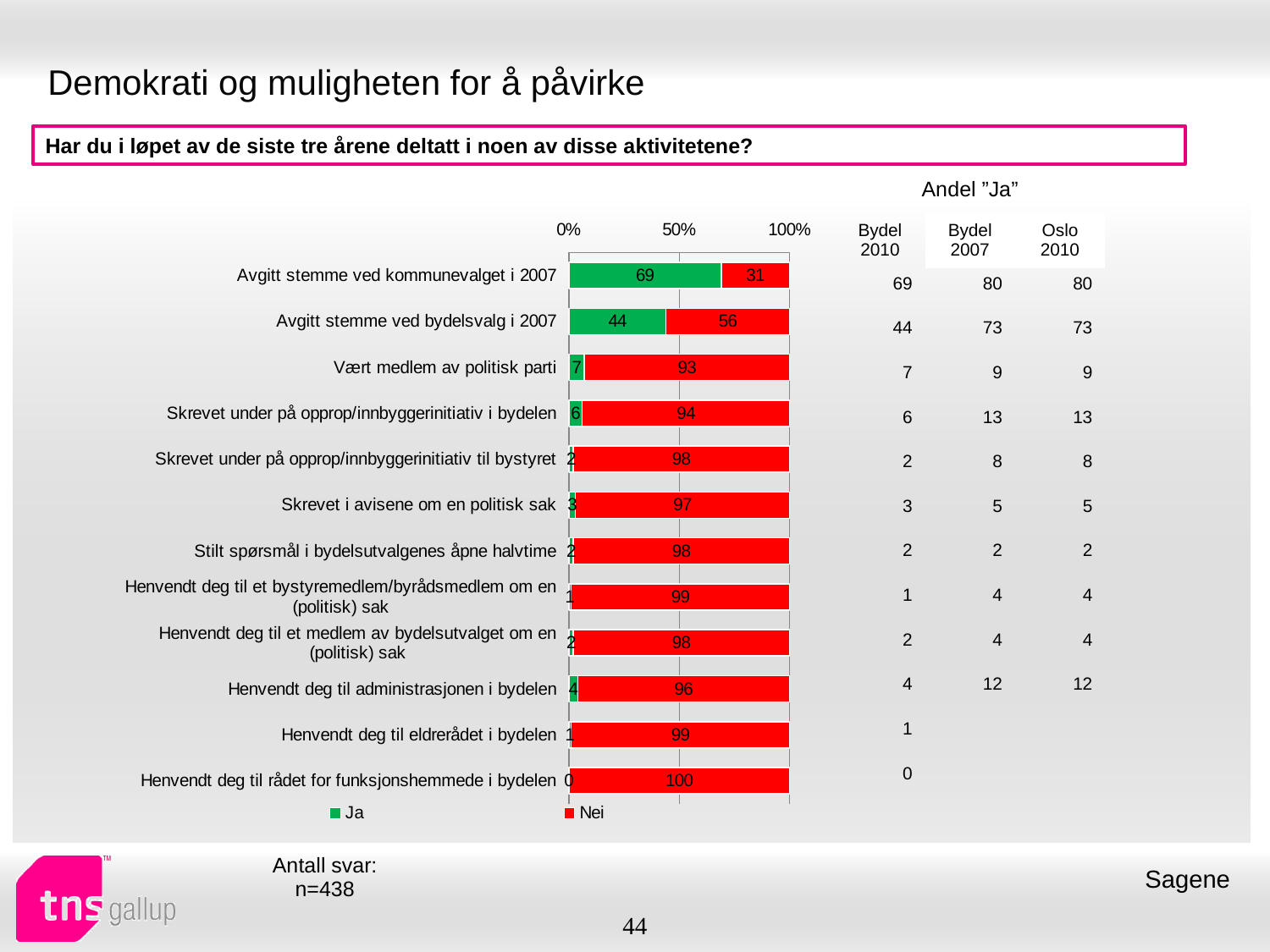
How many series does the chart legend list? 2 Which is larger: the 'Ja' value for 'Vært medlem av politisk parti' or for 'Henvendt deg til administrasjonen i bydelen'? Vært medlem av politisk parti Which colour represents the 'Nei' series in the chart? red What kind of chart is shown on the slide? stacked bar chart Which category has the lowest 'Ja' value? Henvendt deg til rådet for funksjonshemmede i bydelen Which category has the highest 'Ja' value? Avgitt stemme ved kommunevalget i 2007 What is the difference between the 'Ja' values for 'Avgitt stemme ved kommunevalget i 2007' and 'Avgitt stemme ved bydelsvalg i 2007'? 25 How many categories (activities) are plotted in the chart? 12 Is the 'Ja' value for 'Avgitt stemme ved bydelsvalg i 2007' greater or less than 50%? less What is the 'Nei' value for 'Vært medlem av politisk parti'? 93 What is the 'Ja' value for 'Avgitt stemme ved kommunevalget i 2007'? 69 What is the 'Nei' value for 'Avgitt stemme ved bydelsvalg i 2007'? 56